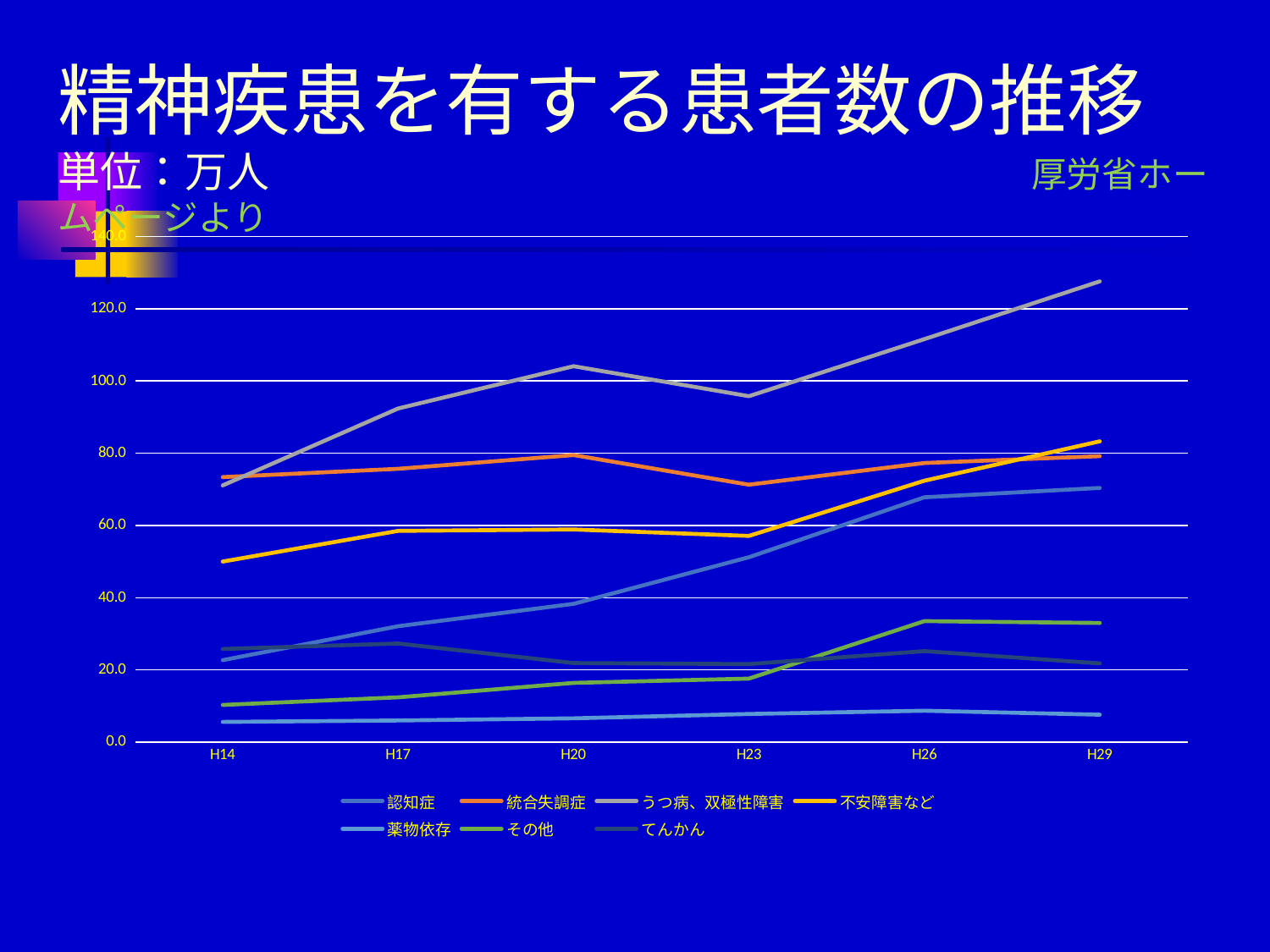
What kind of chart is shown on the slide? line chart How many series does the legend list? 7 Is the value for 薬物依存 at H14 greater or less than 20.0? less What unit is stated for the values on the slide? 万人 How many points are on the x axis of the chart? 6 Do the values for 認知症 rise or fall from H14 to H29? rise Is the value for 不安障害など at H29 greater or less than 60.0? greater Is the value for うつ病、双極性障害 at H29 greater or less than 120.0? greater Which series has the lowest value at H29? 薬物依存 At H14, which is larger: 統合失調症 or 不安障害など? 統合失調症 Which series has the highest value at H29? うつ病、双極性障害